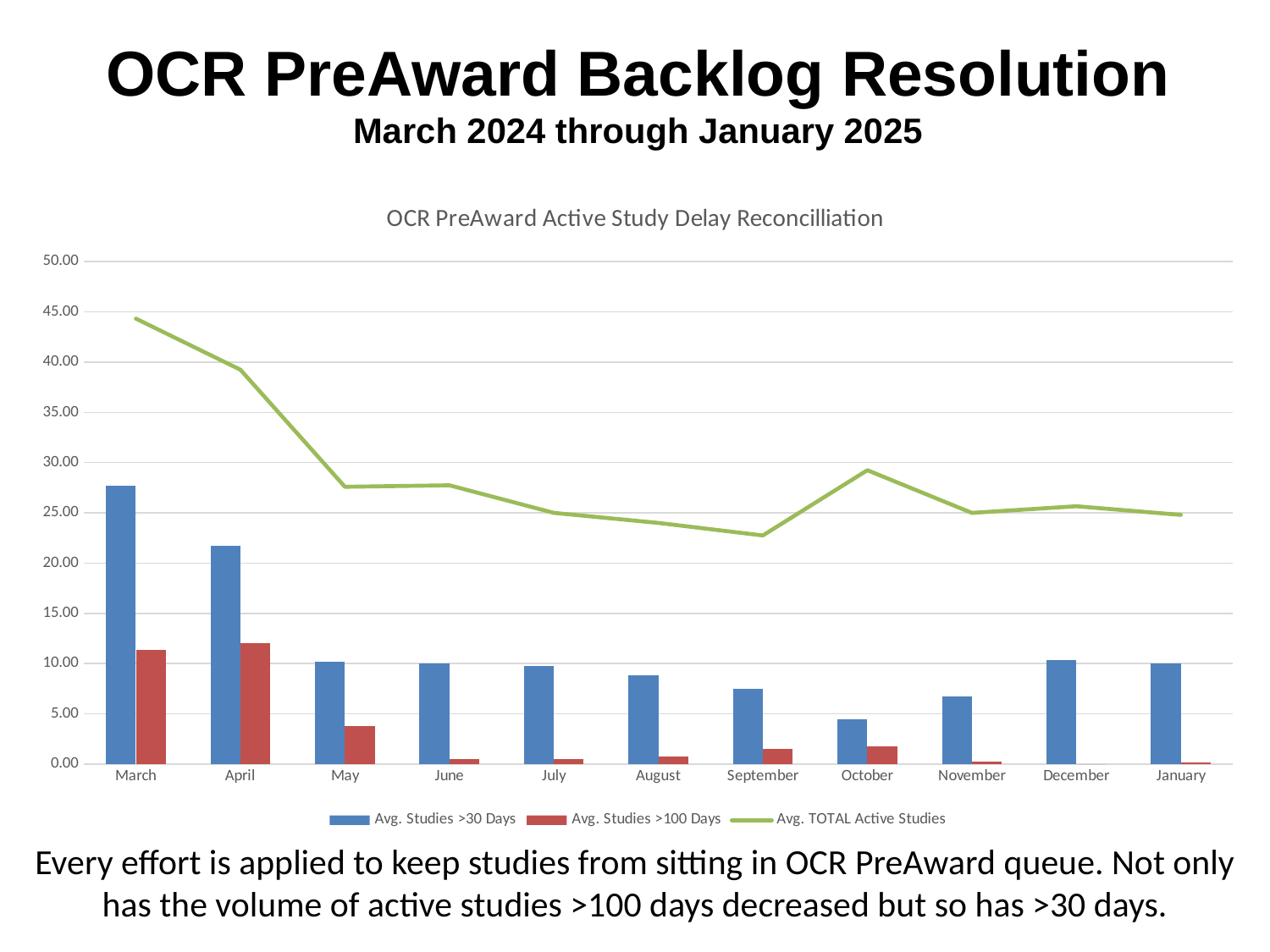
Is the value for Avg. TOTAL Active Studies in March greater or less than 40? greater Which month has the lowest value for Avg. Studies >30 Days? October Which is larger, the Avg. Studies >30 Days value for March or for April? March Is the value for Avg. TOTAL Active Studies in September greater or less than 25? less What kind of chart is shown on the slide? A combination bar and line chart What colour represents the Avg. Studies >100 Days series in the chart? Red Which month has the lowest value for Avg. TOTAL Active Studies? September Does the Avg. TOTAL Active Studies line generally rise or fall from March to January? fall How many series does the chart legend list? 3 Is the value for Avg. Studies >30 Days in March greater or less than 25? greater How many months are shown on the x axis of the chart? 11 Which month has the highest value for Avg. Studies >30 Days? March